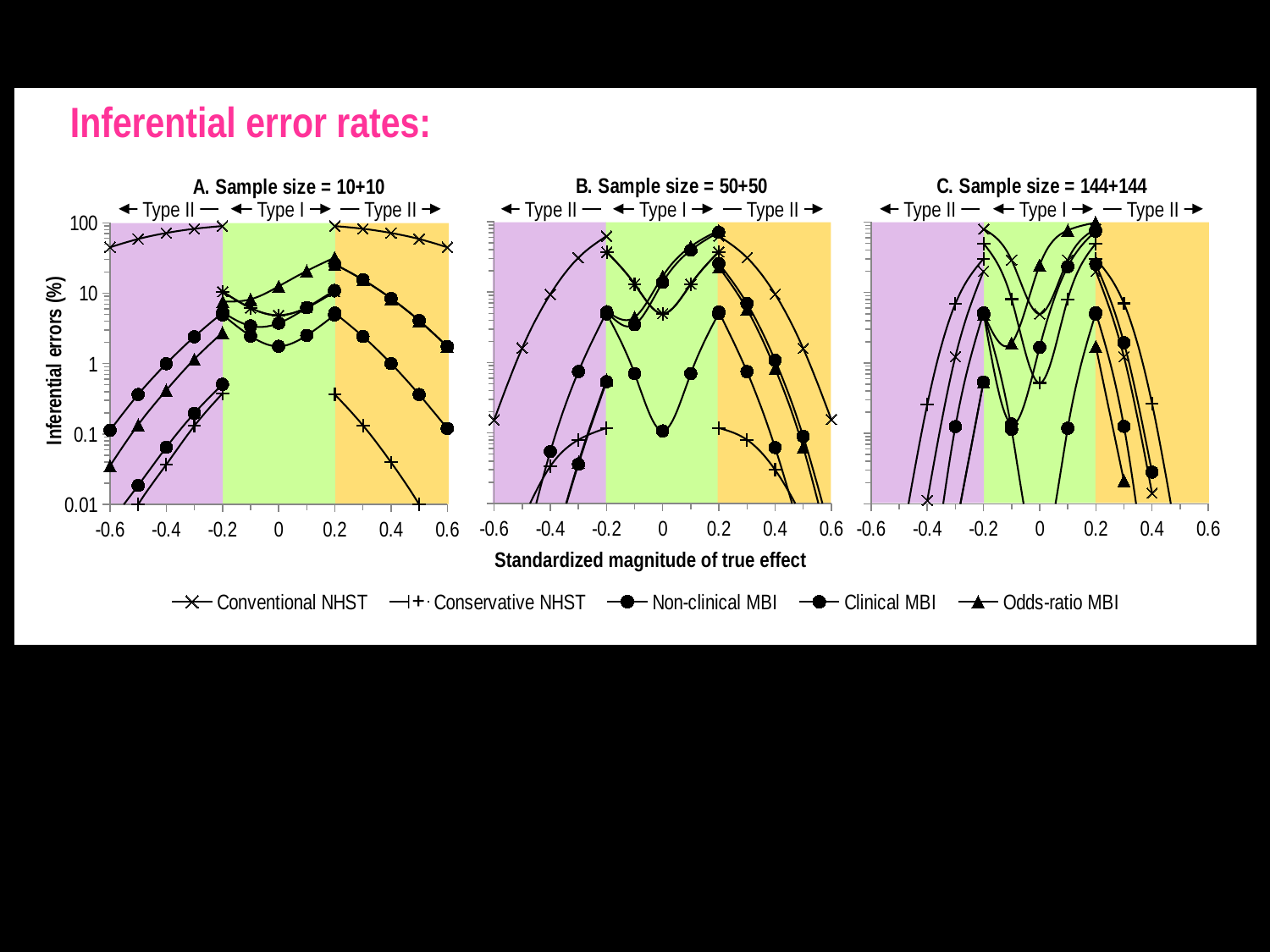
How many series does the legend list? 5 In panel A (Sample size = 10+10), is the Odds-ratio MBI value at x = -0.6 greater or less than 0.1? less In panel A (Sample size = 10+10), which series has the highest value at x = -0.6? Conventional NHST What kind of chart is used in each of the three panels on the slide? Line chart How many chart panels are shown on the slide? 3 In panel C (Sample size = 144+144), is the Conventional NHST value at x = -0.4 greater or less than 0.1? less What is the sample size given in the title of panel C? 144+144 In panel B (Sample size = 50+50), is the Conventional NHST value at x = 0.6 greater or less than 1? less What is the label of the shared x axis? Standardized magnitude of true effect In panel A (Sample size = 10+10), does the Conservative NHST line rise or fall from x = 0.2 to x = 0.5? fall